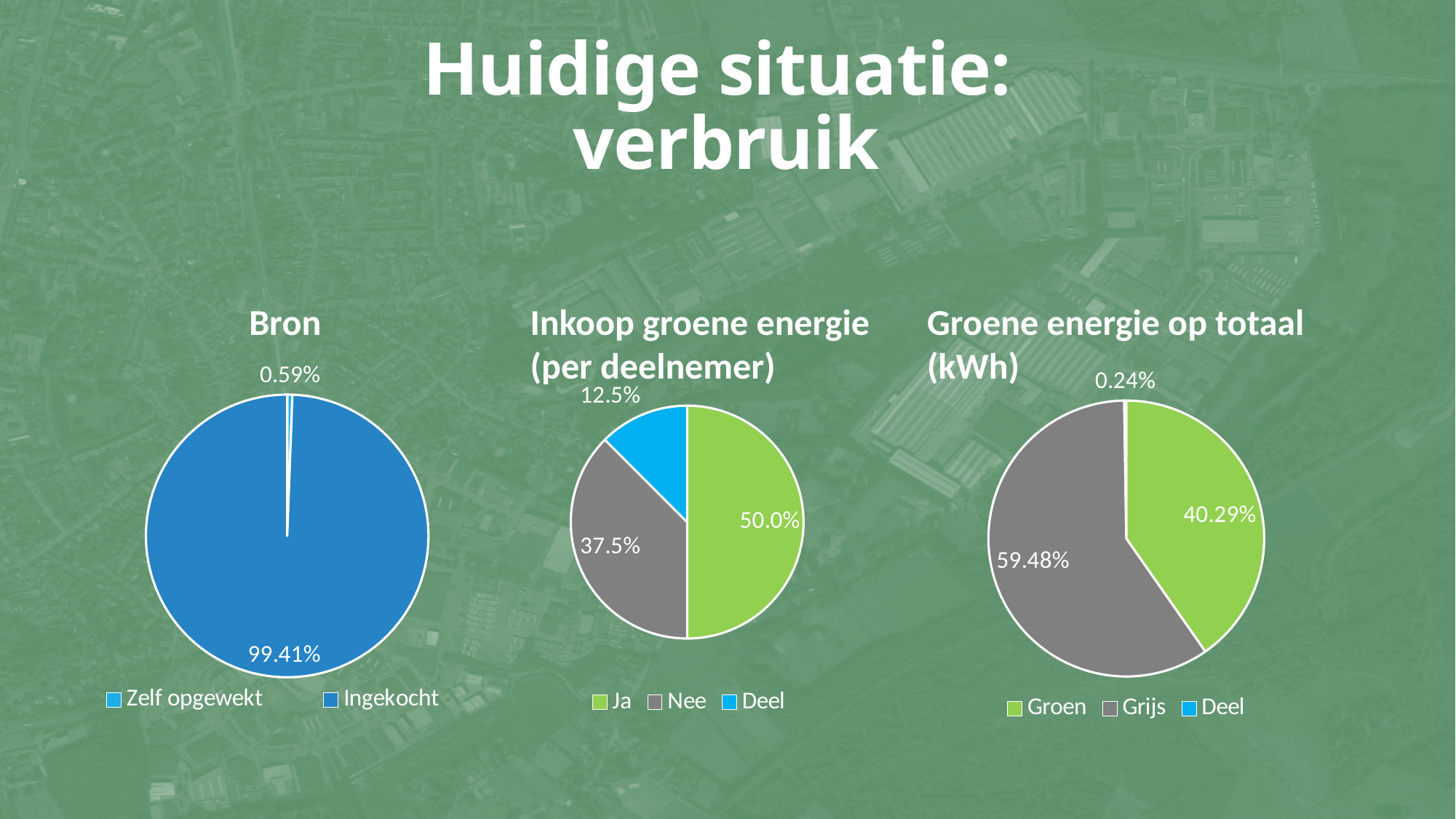
In the 'Inkoop groene energie (per deelnemer)' chart, which category has the largest share? Ja In the 'Inkoop groene energie (per deelnemer)' chart, which is larger: 'Nee' or 'Deel'? Nee What kind of chart is the 'Bron' chart? Pie chart In the 'Inkoop groene energie (per deelnemer)' chart, what share is 'Deel'? 12.5% In the 'Bron' chart, what share is 'Ingekocht'? 99.41% In the 'Groene energie op totaal (kWh)' chart, which category has the smallest share? Deel How many series does the legend of the 'Groene energie op totaal (kWh)' chart list? 3 In the 'Inkoop groene energie (per deelnemer)' chart, what share is 'Nee'? 37.5% In the 'Bron' chart, what share is 'Zelf opgewekt'? 0.59% In the 'Groene energie op totaal (kWh)' chart, what share is 'Grijs'? 59.48% In the 'Groene energie op totaal (kWh)' chart, what share is 'Groen'? 40.29% In the 'Groene energie op totaal (kWh)' chart, what is the difference between the 'Grijs' and 'Groen' shares? 19.19%